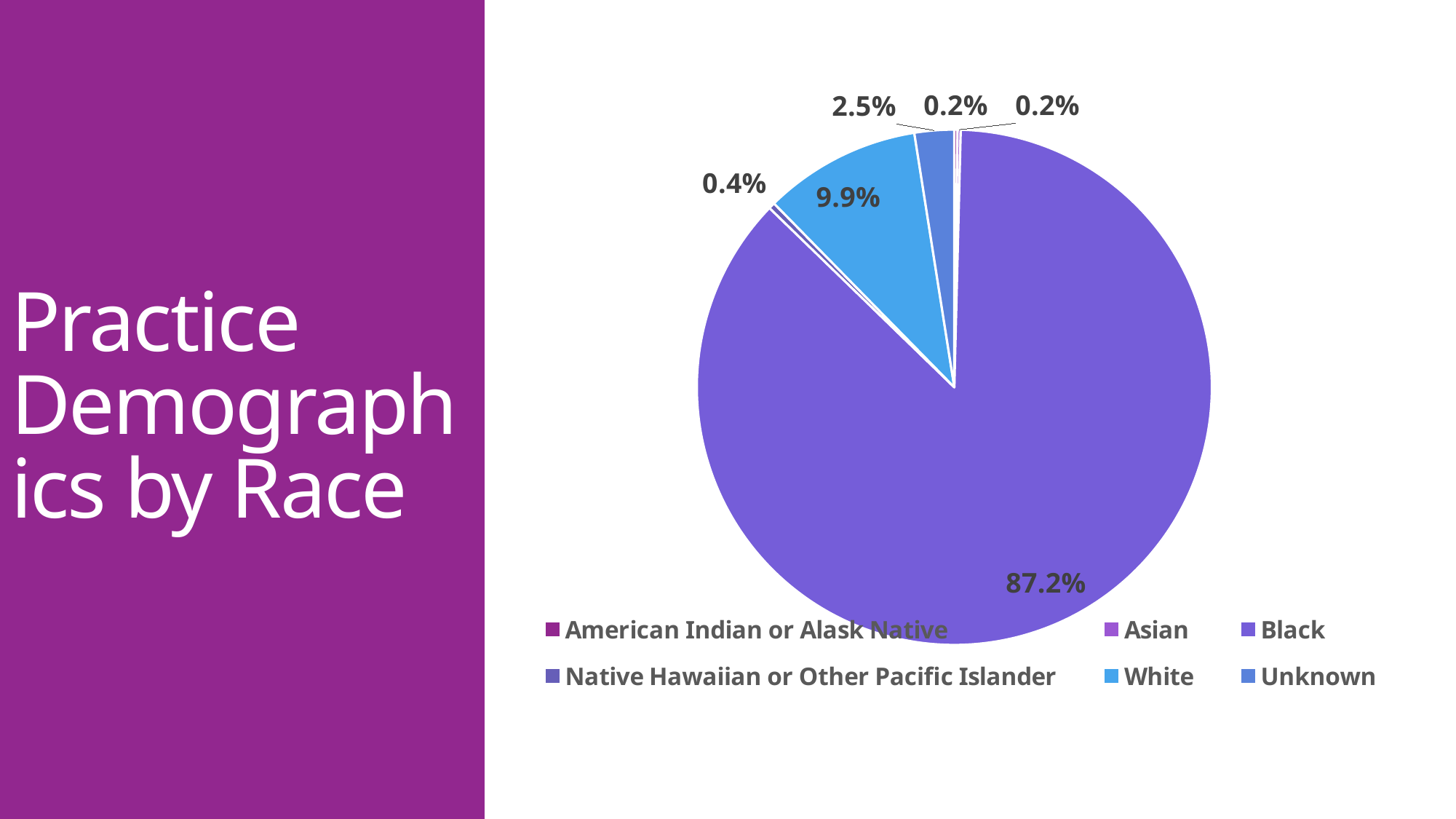
What share of the pie does the White slice represent? 9.9% How many categories does the legend of the pie chart list? 6 What is the title of the slide containing the pie chart? Practice Demographics by Race What percentage is shown for the Unknown slice? 2.5% Which slice is larger, White or Unknown? White What percentage is shown for the Black slice? 87.2% What percentage is shown for the Native Hawaiian or Other Pacific Islander slice? 0.4% What kind of chart is shown on the slide? pie chart What is the difference between the Black slice and the White slice? 77.3% Which category has the largest slice in the pie chart? Black How many slices does the pie chart have? 6 What percentage is shown for the White slice? 9.9%